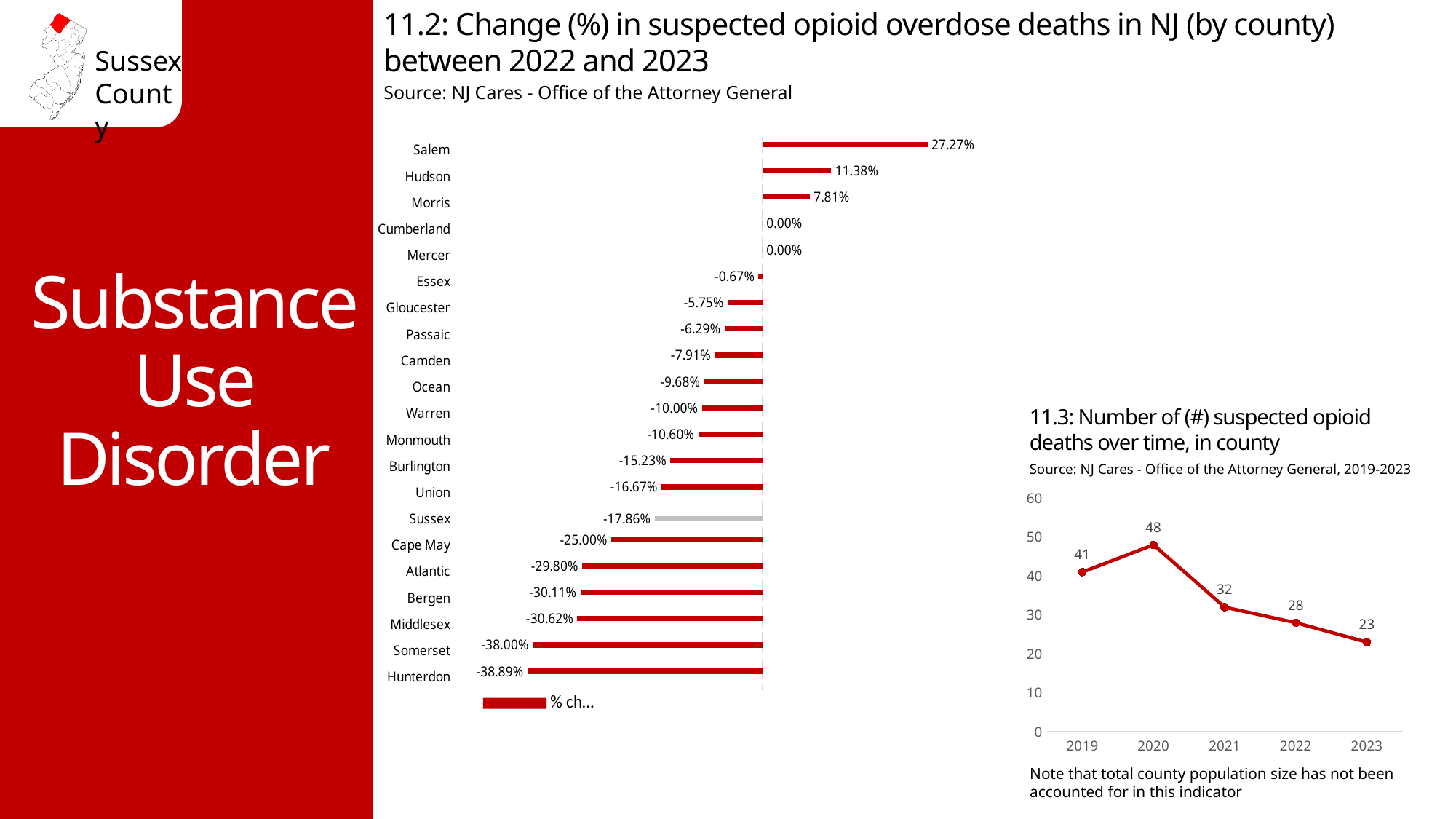
In the chart '11.2: Change (%) in suspected opioid overdose deaths in NJ (by county) between 2022 and 2023', which is larger, the value for Bergen or the value for Middlesex? Bergen What kind of chart is '11.2: Change (%) in suspected opioid overdose deaths in NJ (by county) between 2022 and 2023'? Bar chart In the chart '11.2: Change (%) in suspected opioid overdose deaths in NJ (by county) between 2022 and 2023', what is the value for Sussex? -17.86% In the chart '11.2: Change (%) in suspected opioid overdose deaths in NJ (by county) between 2022 and 2023', which county has the lowest value? Hunterdon In the chart '11.2: Change (%) in suspected opioid overdose deaths in NJ (by county) between 2022 and 2023', what is the value for Hudson? 11.38% In the chart '11.3: Number of (#) suspected opioid deaths over time, in county', what is the value for 2020? 48 In the chart '11.3: Number of (#) suspected opioid deaths over time, in county', do the values rise or fall from 2020 to 2023? Fall What kind of chart is '11.3: Number of (#) suspected opioid deaths over time, in county'? Line chart In the chart '11.3: Number of (#) suspected opioid deaths over time, in county', which year has the lowest value? 2023 In the chart '11.3: Number of (#) suspected opioid deaths over time, in county', what is the difference between the values for 2019 and 2023? 18 In the chart '11.2: Change (%) in suspected opioid overdose deaths in NJ (by county) between 2022 and 2023', which county has the highest value? Salem In the chart '11.2: Change (%) in suspected opioid overdose deaths in NJ (by county) between 2022 and 2023', how many counties are shown? 21